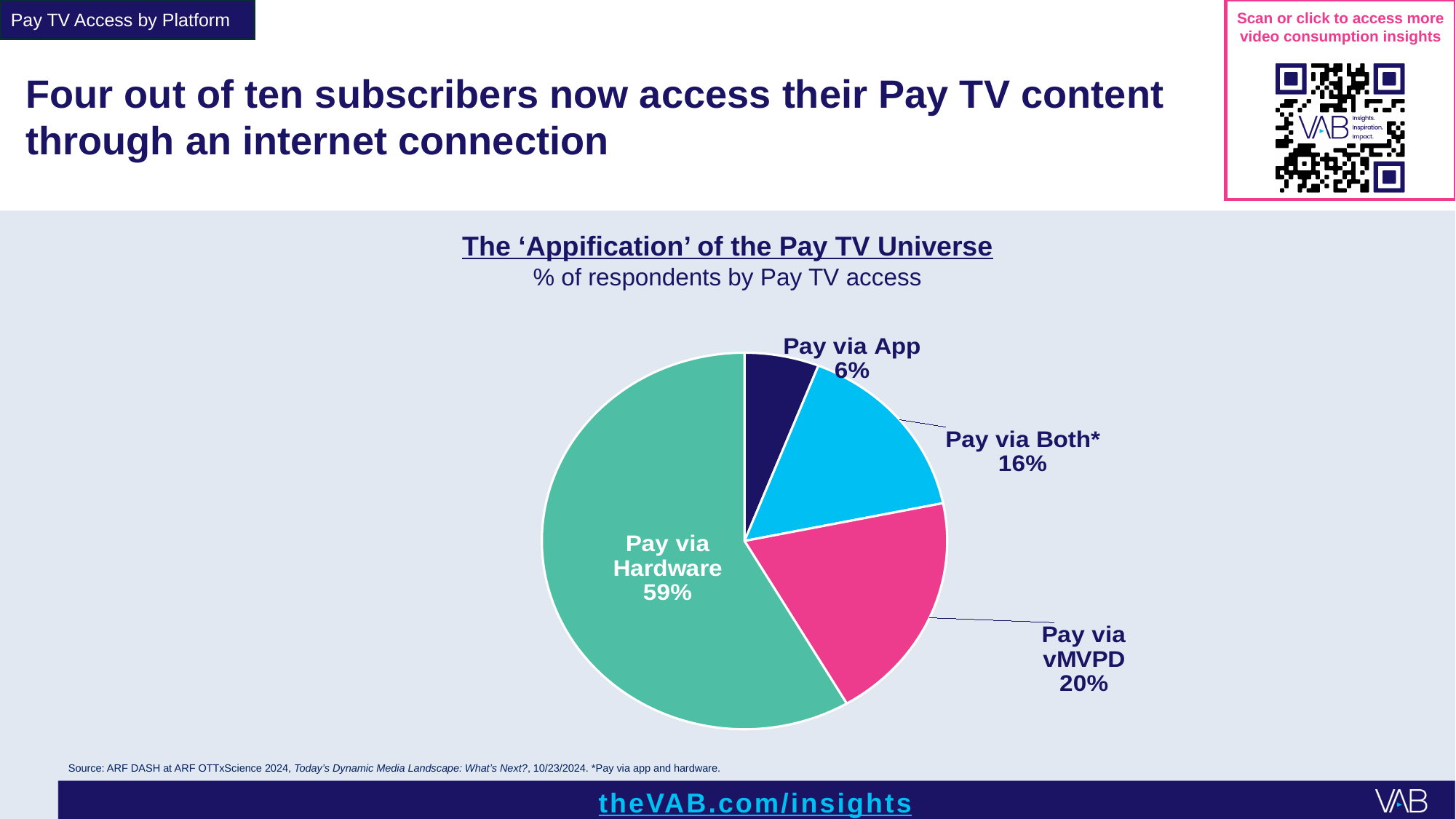
Which is larger, the share for Pay via Both or the share for Pay via App? Pay via Both How many slices does the pie chart have? 4 Which Pay TV access category has the smallest share? Pay via App What percentage of respondents access Pay TV via vMVPD? 20% What is the title of the chart? The 'Appification' of the Pay TV Universe What is the difference in percentage points between Pay via Hardware and Pay via vMVPD? 39 What colour is the Pay via vMVPD slice? Pink What percentage of respondents access Pay TV via Both? 16% What percentage of respondents access Pay TV via App? 6% What type of chart is shown on the slide? Pie chart What percentage of respondents access Pay TV via Hardware? 59% Which Pay TV access category has the largest share? Pay via Hardware